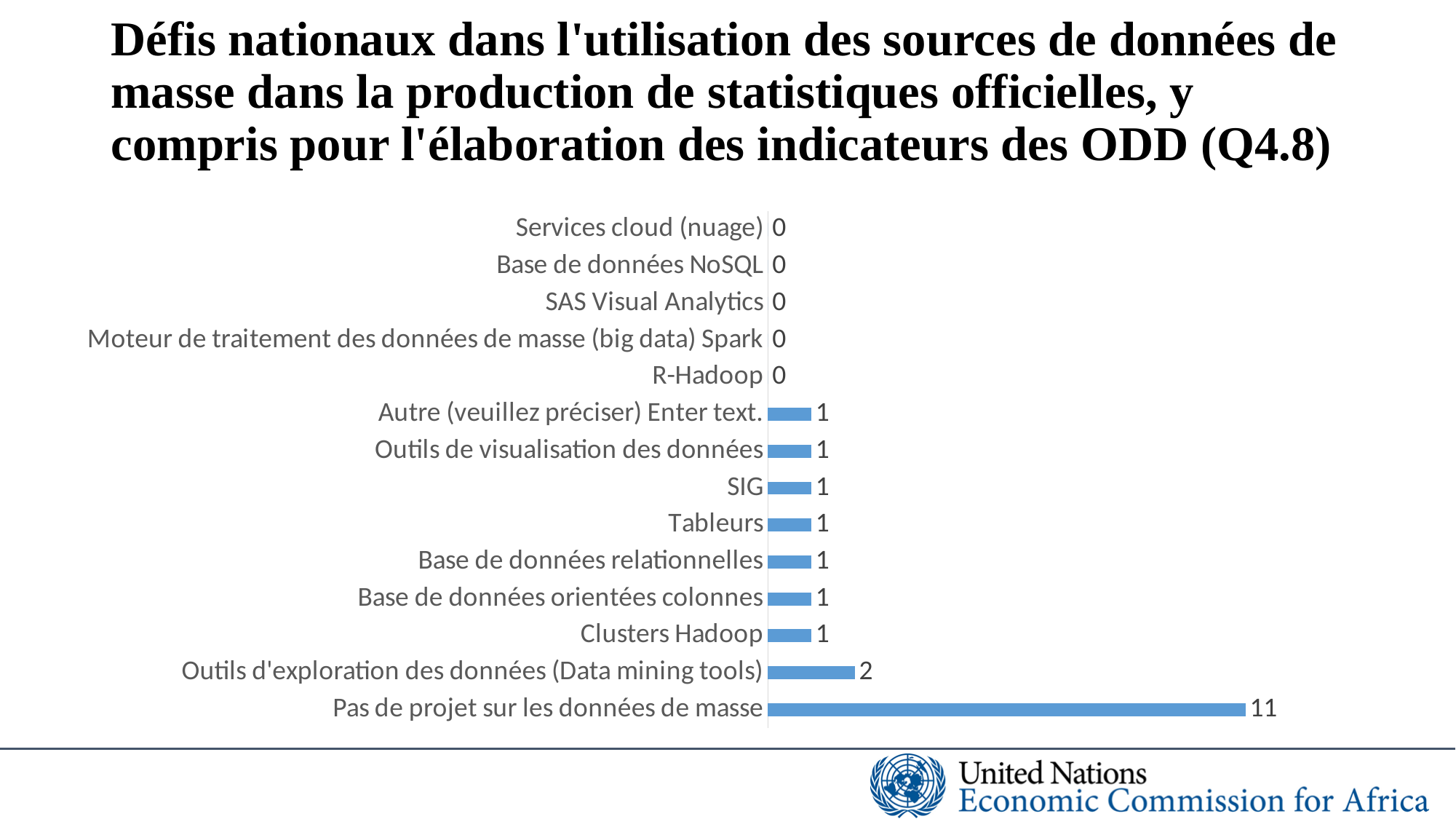
What is the value for "R-Hadoop"? 0 Which category has the highest value? Pas de projet sur les données de masse How many categories are shown in the chart? 14 What is the value for "Outils d'exploration des données (Data mining tools)"? 2 What is the value for "Pas de projet sur les données de masse"? 11 What is the difference between the values for "Pas de projet sur les données de masse" and "Outils d'exploration des données (Data mining tools)"? 9 What is the value for "Clusters Hadoop"? 1 What is the value for "Services cloud (nuage)"? 0 How many categories have a value of 0? 5 What kind of chart is shown on the slide? Bar chart Which is larger, the value for "Outils d'exploration des données (Data mining tools)" or the value for "SIG"? Outils d'exploration des données (Data mining tools) How many categories have a value of 1? 7